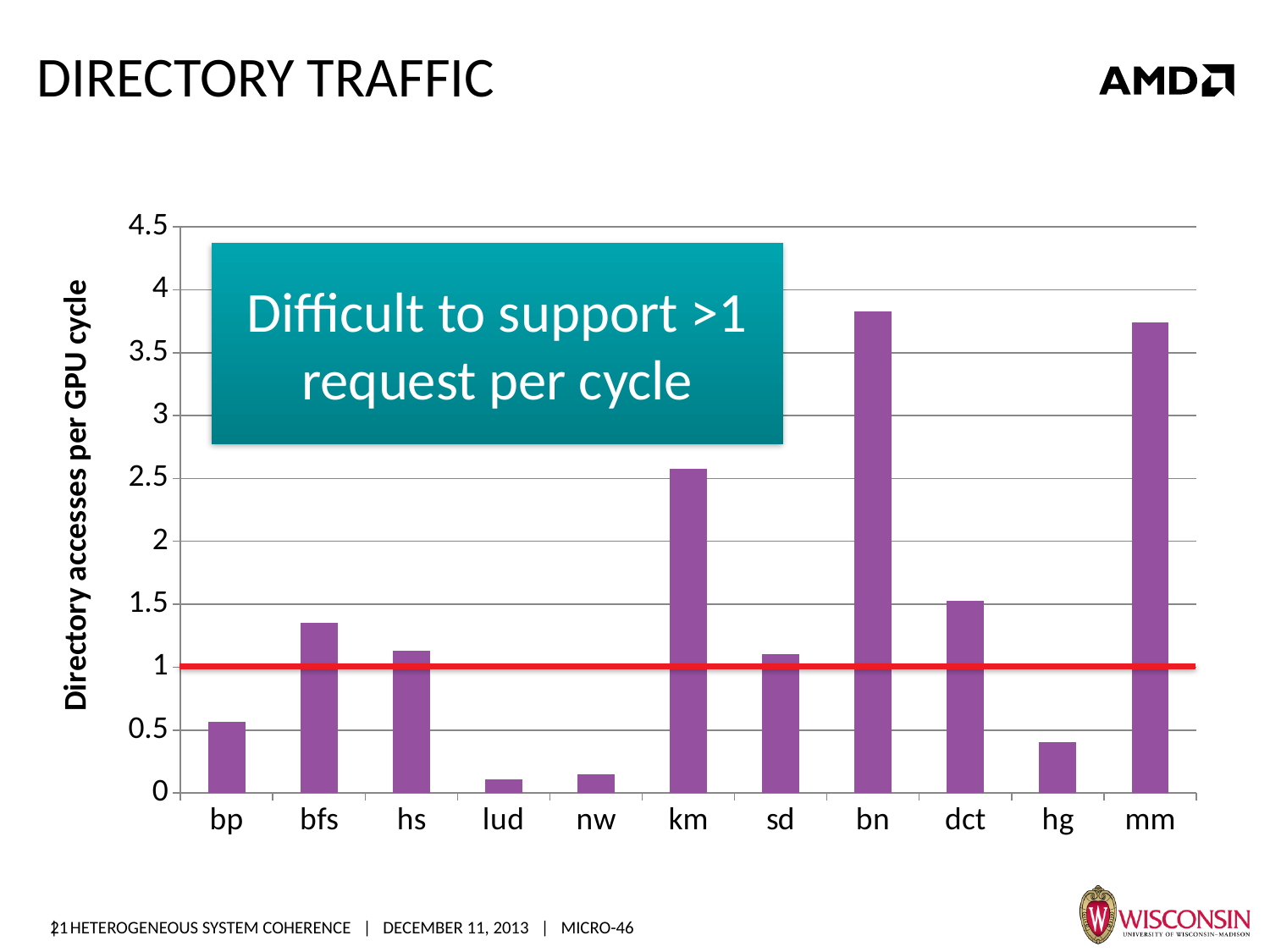
How many categories are shown on the x axis of the chart? 11 Is the value for km greater or less than 2? greater Is the value for mm greater or less than 3.5? greater Is the value for bp greater or less than 1? less What is the label of the y axis? Directory accesses per GPU cycle What kind of chart is shown on the slide? bar chart At what y-axis value is the horizontal red line drawn? 1 Which has a larger value, bfs or bp? bfs Which has a larger value, km or dct? km